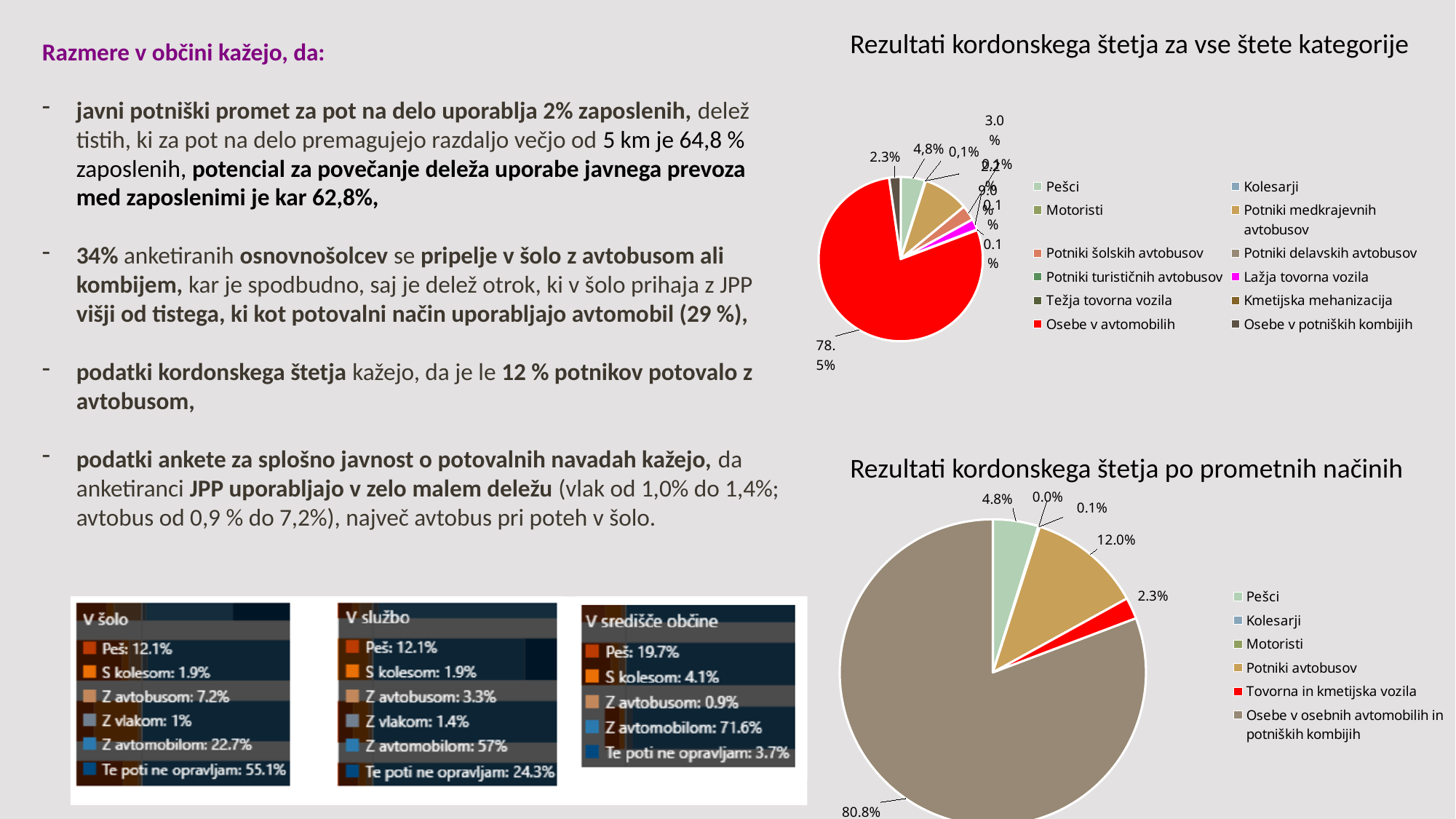
In the chart titled 'Rezultati kordonskega štetja za vse štete kategorije', what share is shown for Osebe v avtomobilih? 78.5% In the chart titled 'Rezultati kordonskega štetja po prometnih načinih', which is larger: Pešci or Tovorna in kmetijska vozila? Pešci In the chart titled 'Rezultati kordonskega štetja po prometnih načinih', what share is shown for Osebe v osebnih avtomobilih in potniških kombijih? 80.8% In the chart titled 'Rezultati kordonskega štetja po prometnih načinih', what is the difference in percentage points between Osebe v osebnih avtomobilih in potniških kombijih and Potniki avtobusov? 68.8 What kind of chart is 'Rezultati kordonskega štetja za vse štete kategorije'? Pie chart In the chart titled 'Rezultati kordonskega štetja po prometnih načinih', which category has the largest share? Osebe v osebnih avtomobilih in potniških kombijih In the chart titled 'Rezultati kordonskega štetja po prometnih načinih', which category has the smallest share? Kolesarji In the chart titled 'Rezultati kordonskega štetja po prometnih načinih', what share is shown for Potniki avtobusov? 12.0% In the chart titled 'Rezultati kordonskega štetja po prometnih načinih', what share is shown for Pešci? 4.8% In the chart titled 'Rezultati kordonskega štetja po prometnih načinih', what share is shown for Tovorna in kmetijska vozila? 2.3% In the chart titled 'Rezultati kordonskega štetja za vse štete kategorije', which category has the largest share? Osebe v avtomobilih How many categories does the legend of the chart titled 'Rezultati kordonskega štetja po prometnih načinih' list? 6